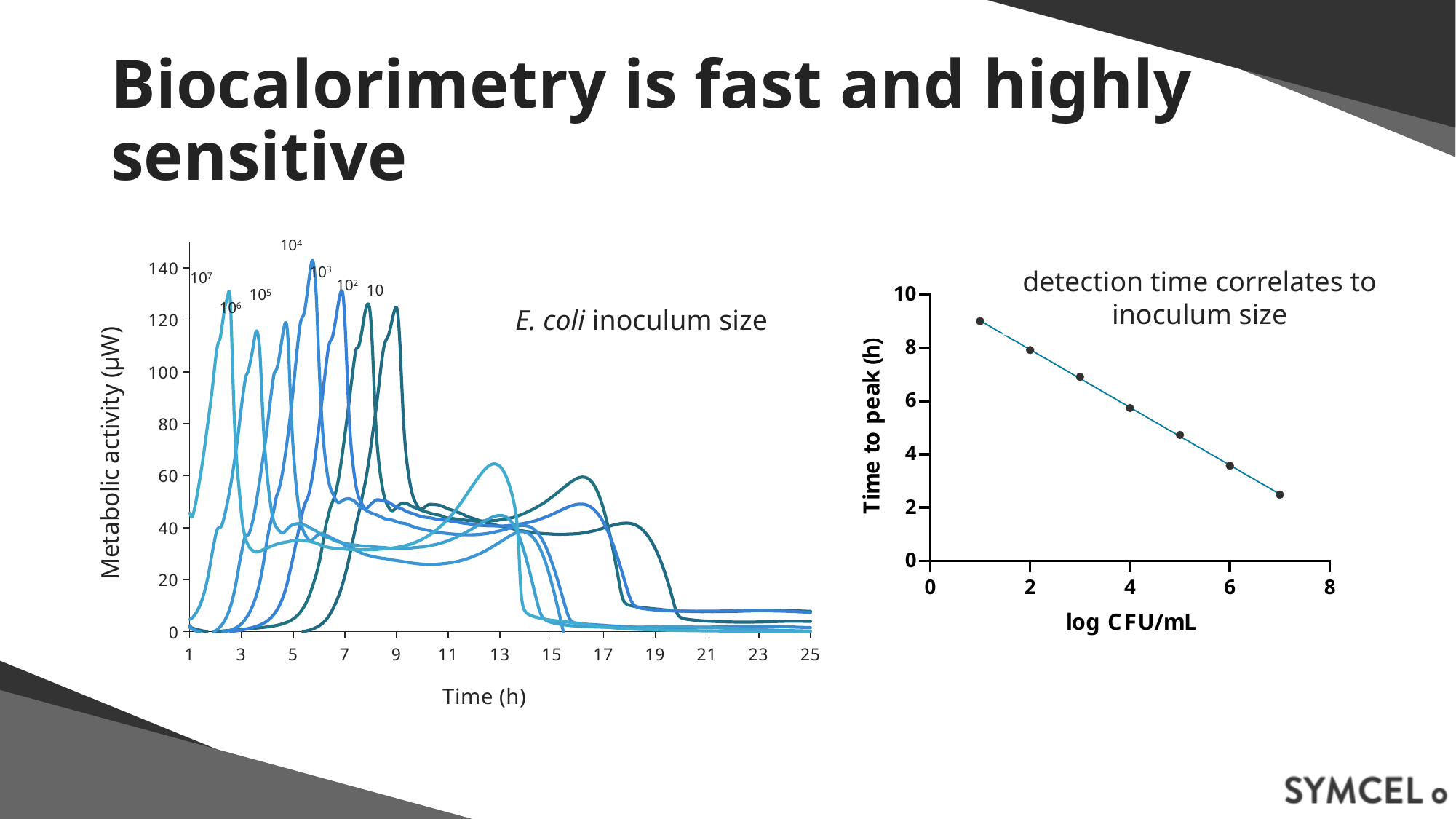
What is the y-axis label of the left chart? Metabolic activity (µW) On the left chart, how many inoculum-size curves are plotted? 7 On the left chart, which inoculum size curve has the highest peak metabolic activity? 10^4 On the left chart, is the peak metabolic activity of the 10^7 curve greater or less than 120 µW? greater On the right chart 'detection time correlates to inoculum size', is the time to peak at log CFU/mL = 1 greater or less than 8 h? greater What is the title of the right chart? detection time correlates to inoculum size On the right chart 'detection time correlates to inoculum size', does time to peak rise or fall as log CFU/mL increases? fall On the right chart 'detection time correlates to inoculum size', how many data points are plotted? 7 On the right chart 'detection time correlates to inoculum size', is the time to peak at log CFU/mL = 7 greater or less than 4 h? less On the left chart, which inoculum size curve reaches its peak earliest in time? 10^7 What kind of chart is the left chart showing metabolic activity over time? line chart